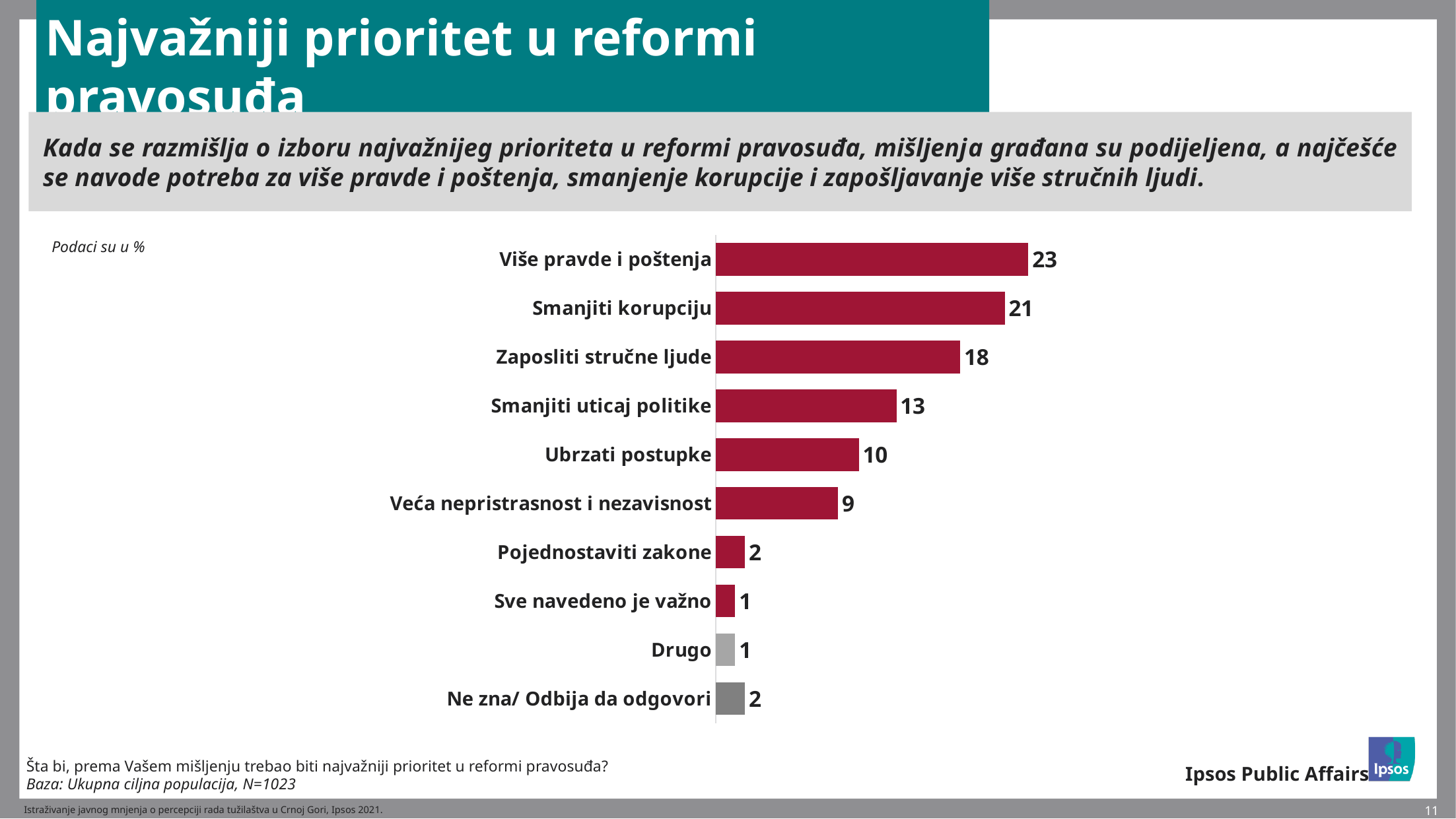
Which is larger, the value for "Ubrzati postupke" or the value for "Veća nepristrasnost i nezavisnost"? Ubrzati postupke What is the value for "Ne zna/ Odbija da odgovori"? 2 What is the value for "Više pravde i poštenja"? 23 What is the value for "Veća nepristrasnost i nezavisnost"? 9 What kind of chart is shown on the slide? Bar chart What is the value for "Smanjiti uticaj politike"? 13 What unit are the data in, according to the note on the slide? % What is the difference between the values for "Više pravde i poštenja" and "Ubrzati postupke"? 13 How many categories are shown in the chart? 10 What is the value for "Drugo"? 1 Which category has the highest value? Više pravde i poštenja What is the difference between the values for "Smanjiti korupciju" and "Zaposliti stručne ljude"? 3